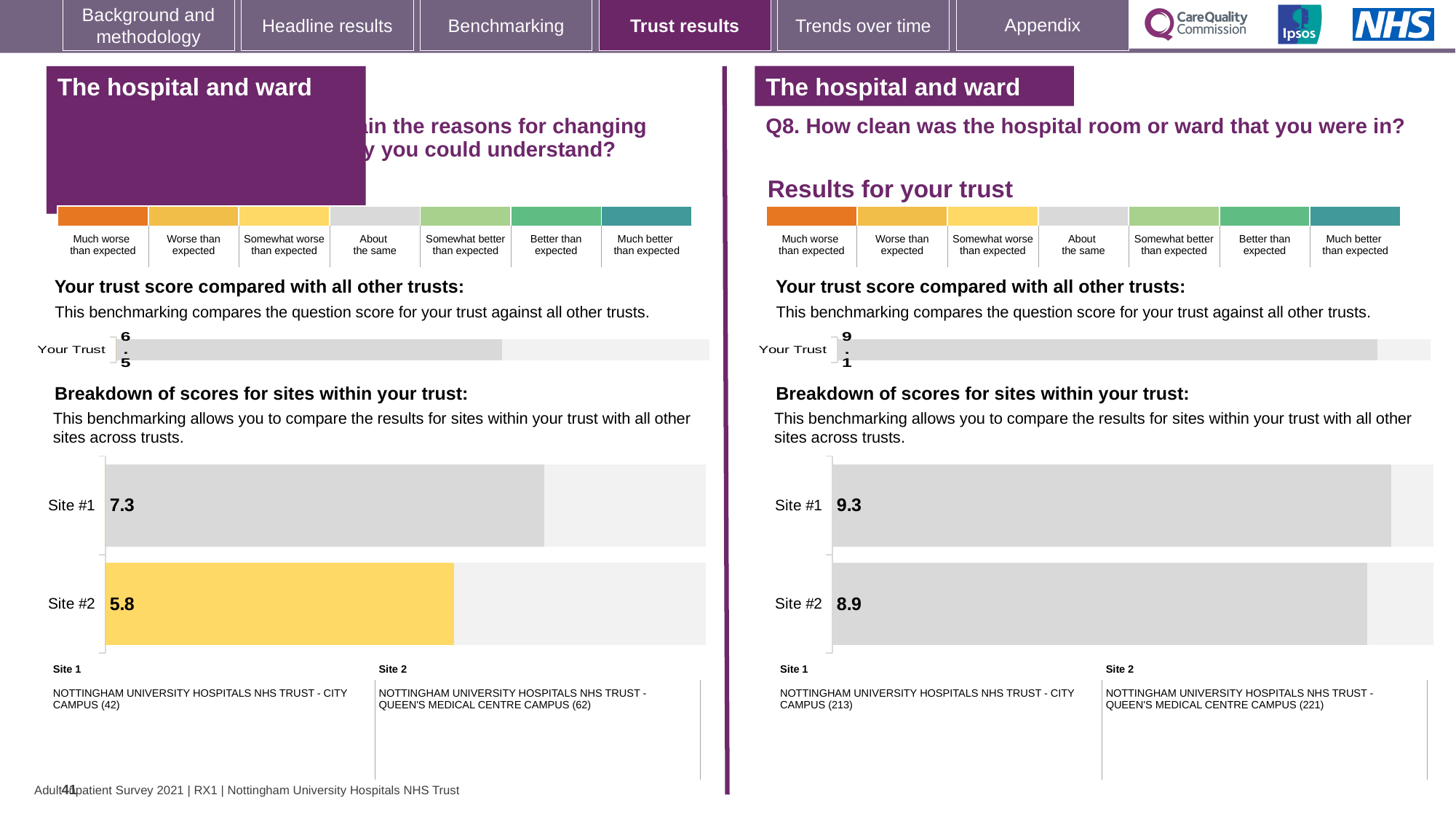
What type of chart is the left-hand 'Breakdown of scores for sites within your trust' chart? Bar chart On the right-hand (Q8) 'Breakdown of scores for sites within your trust' chart, what is the score for Site #2? 8.9 On the left-hand 'Breakdown of scores for sites within your trust' chart, what is the score for Site #1? 7.3 On the left-hand 'Breakdown of scores for sites within your trust' chart, what is the difference between the Site #1 and Site #2 scores? 1.5 On the left-hand 'Breakdown of scores for sites within your trust' chart, what is the score for Site #2? 5.8 How many sites are shown on the right-hand (Q8) 'Breakdown of scores for sites within your trust' chart? 2 On the right-hand (Q8) 'Breakdown of scores for sites within your trust' chart, what is the difference between the Site #1 and Site #2 scores? 0.4 On the right-hand (Q8) 'Your trust score compared with all other trusts' chart, what is the score for Your Trust? 9.1 On the right-hand (Q8) 'Breakdown of scores for sites within your trust' chart, what is the score for Site #1? 9.3 On the left-hand 'Breakdown of scores for sites within your trust' chart, which site has the higher score? Site #1 On the right-hand (Q8) 'Breakdown of scores for sites within your trust' chart, which site has the lower score? Site #2 On the left-hand 'Your trust score compared with all other trusts' chart, what is the score for Your Trust? 6.5